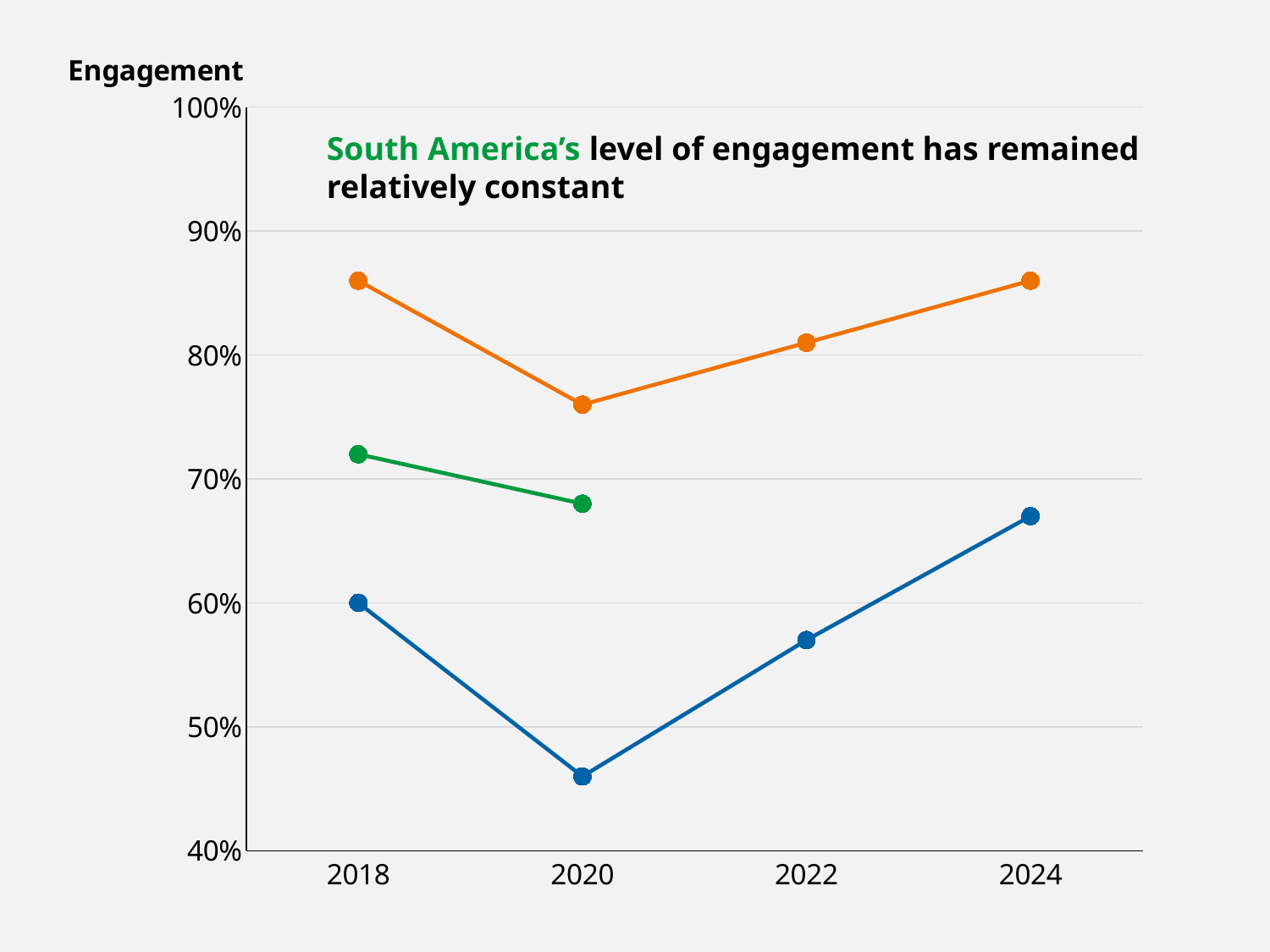
What kind of chart is shown on the slide? line chart In 2018, which line has the higher value, the orange line or the blue line? orange Is the value of the blue line in 2020 greater or less than 50%? less Which region does the green line represent? South America Is the value of the orange line in 2020 greater or less than 80%? less Is the value of the South America (green) line in 2018 greater or less than 70%? greater In which year does the blue line reach its lowest value? 2020 What is the label on the y axis? Engagement How many years are shown on the x axis? 4 Does the blue line rise or fall from 2020 to 2024? rise How many data points does the green (South America) line have? 2